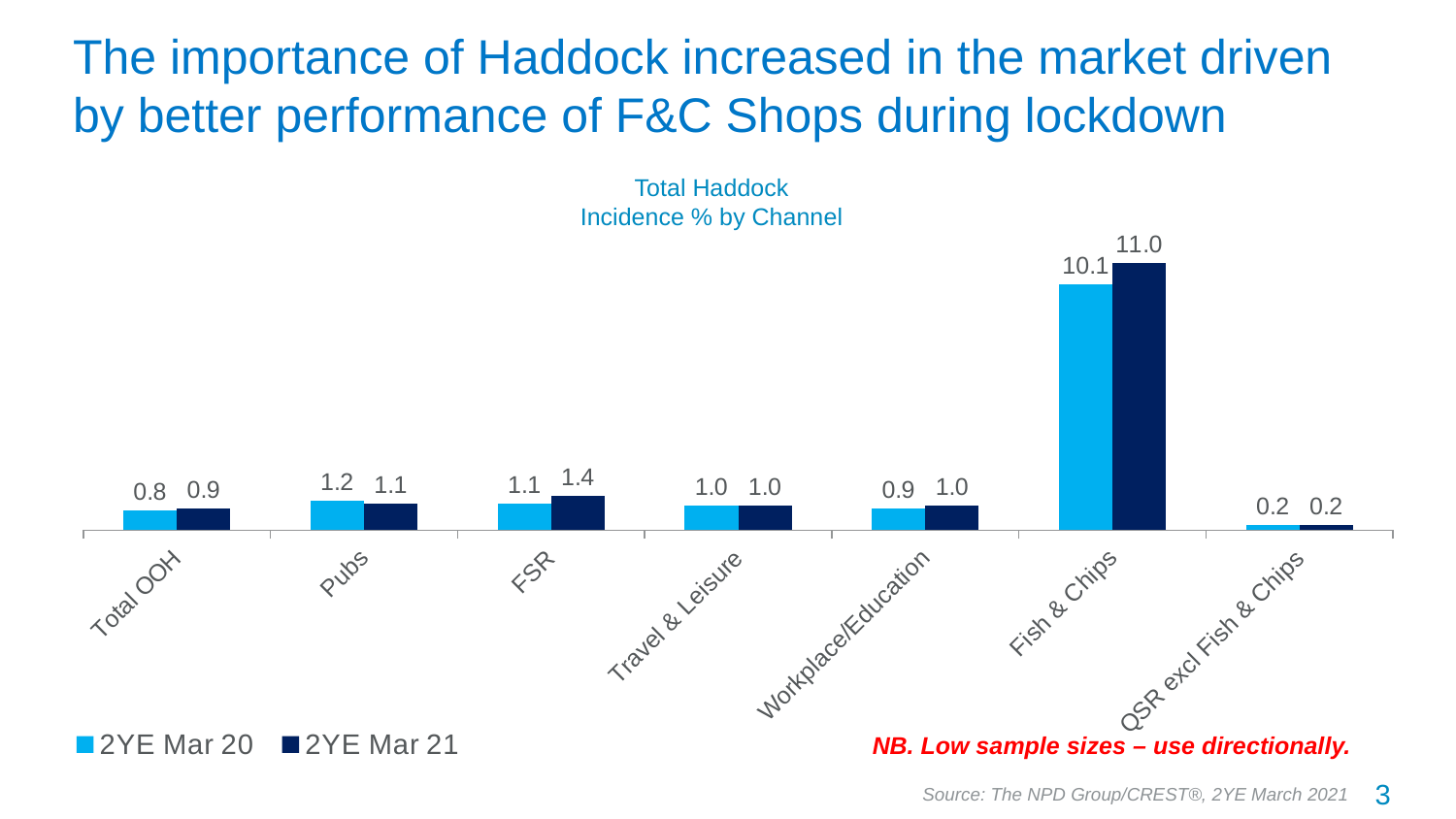
What is the difference between the 2YE Mar 21 and 2YE Mar 20 values for Fish & Chips? 0.9 What kind of chart is shown on the slide? Bar chart How many channels are shown on the x axis? 7 What is the value for FSR in 2YE Mar 21? 1.4 How many series does the legend list? 2 Which channel has the highest incidence % in 2YE Mar 21? Fish & Chips What is the title of the chart? Total Haddock Incidence % by Channel What is the value for Total OOH in 2YE Mar 21? 0.9 What is the Total Haddock incidence % for Fish & Chips in 2YE Mar 21? 11.0 Which is larger for Pubs: the 2YE Mar 20 value or the 2YE Mar 21 value? 2YE Mar 20 Which channel has the lowest incidence % in 2YE Mar 20? QSR excl Fish & Chips What is the value for Pubs in the 2YE Mar 20 series? 1.2